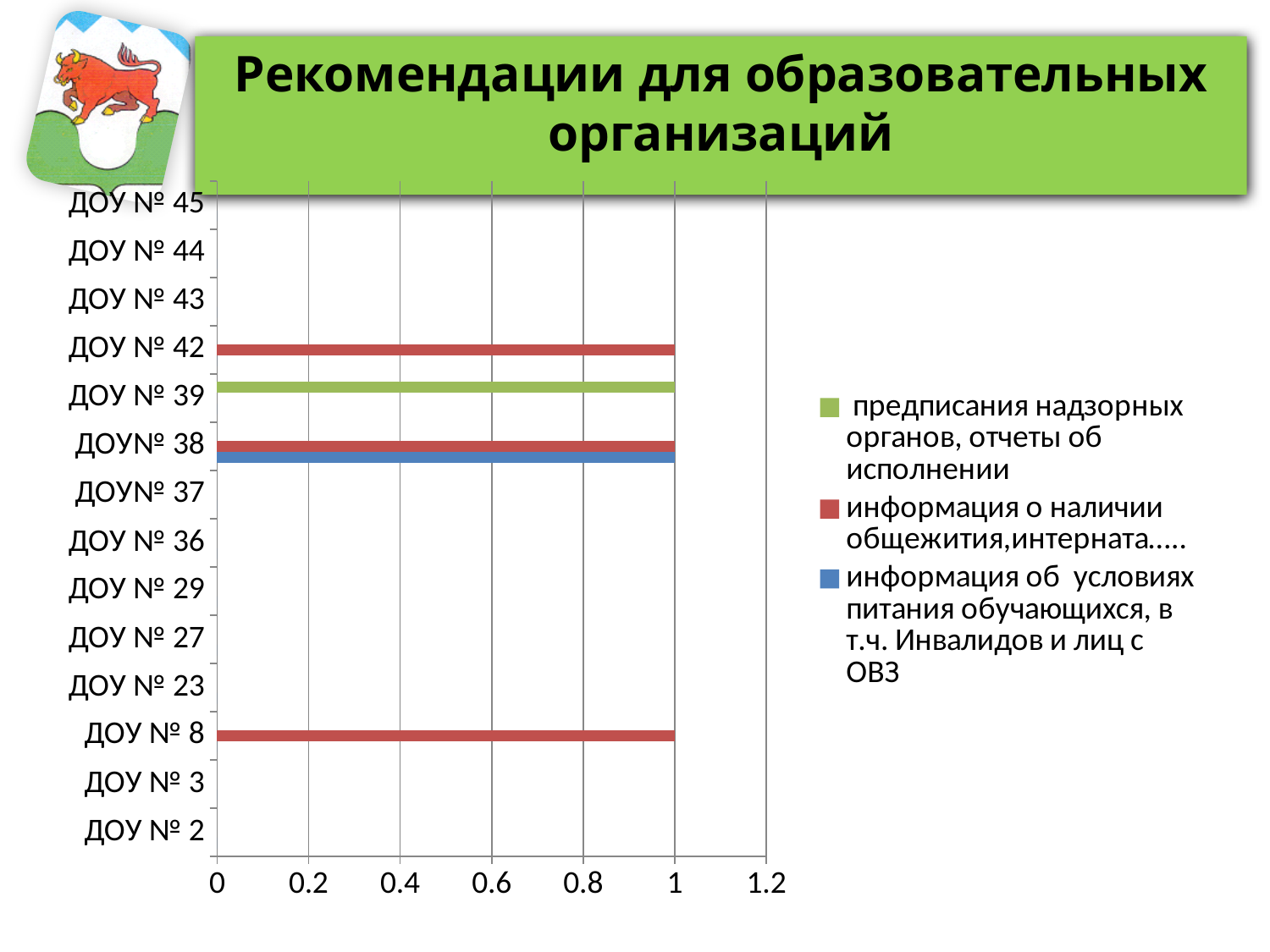
What is the value of the red bar (информация о наличии общежития, интерната…) for ДОУ № 42? 1 How many categories (ДОУ) are listed on the vertical axis of the chart? 14 What kind of chart is shown on the slide? bar chart How many series does the chart legend list? 3 What is the value of the blue bar (информация об условиях питания обучающихся) for ДОУ№ 38? 1 What is the value of the green bar (предписания надзорных органов, отчеты об исполнении) for ДОУ № 39? 1 Which colour in the legend represents 'информация об условиях питания обучающихся, в т.ч. Инвалидов и лиц с ОВЗ'? blue Is the value of the red bar for ДОУ № 42 greater or less than 0.8? greater Which category is the only one with a green bar (предписания надзорных органов, отчеты об исполнении)? ДОУ № 39 What is the maximum value shown on the horizontal axis of the chart? 1.2 Is the value of the green bar for ДОУ № 39 greater or less than 1.2? less What is the value of the red bar for ДОУ № 8? 1